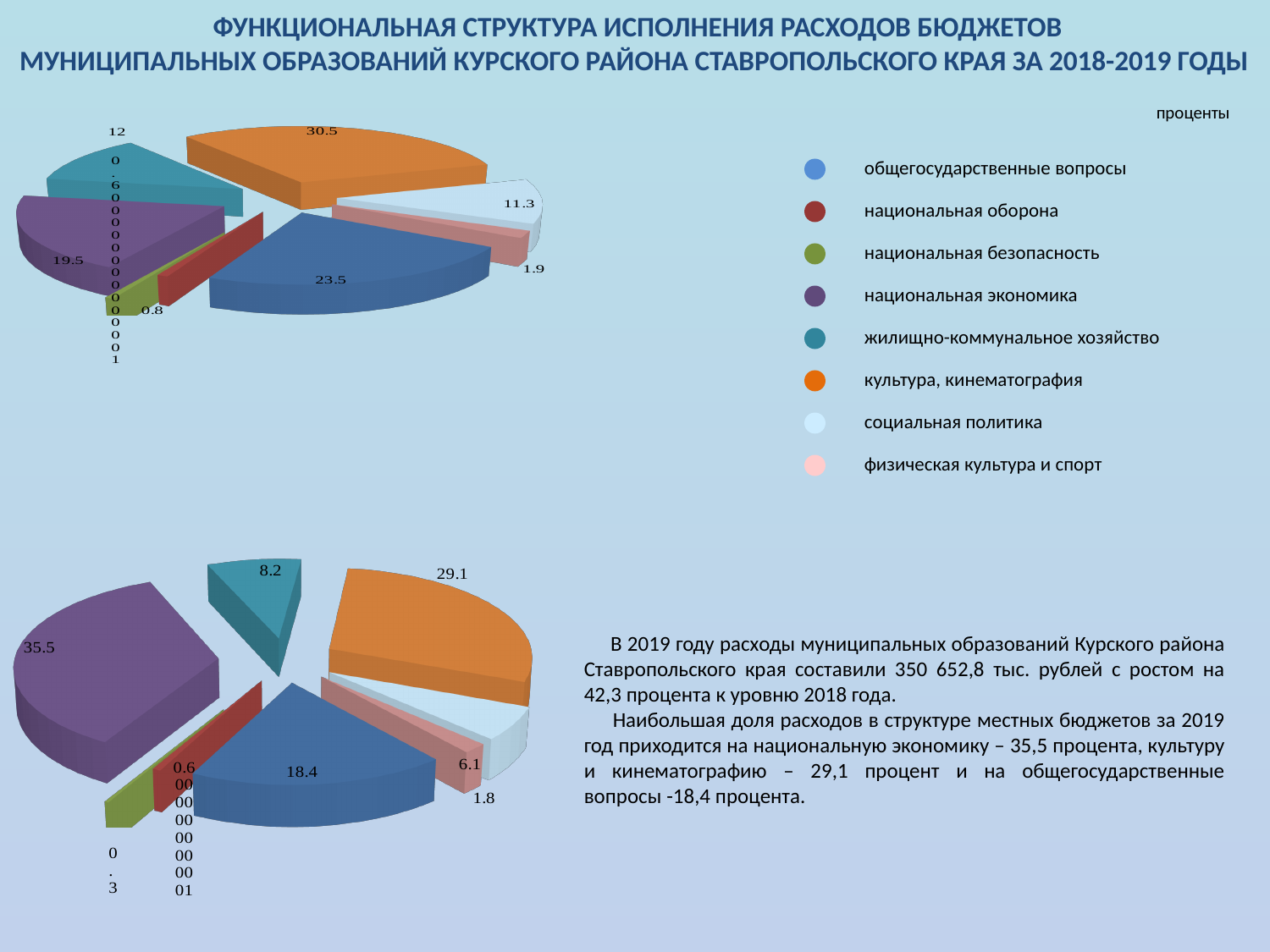
In the top pie chart, what is the value for общегосударственные вопросы? 23.5 In the top pie chart, which category has the largest slice? культура, кинематография How many categories does the legend list? 8 In the bottom pie chart, what is the difference between the values for культура, кинематография and общегосударственные вопросы? 10.7 In the bottom pie chart, which is larger, the value for общегосударственные вопросы or the value for социальная политика? общегосударственные вопросы In the top pie chart, what is the difference between the values for социальная политика and физическая культура и спорт? 9.4 What type of chart is the bottom chart? pie chart In the bottom pie chart, what is the value for жилищно-коммунальное хозяйство? 8.2 In the bottom pie chart, what is the value for национальная экономика? 35.5 In the top pie chart, what is the value for культура, кинематография? 30.5 In the top pie chart, what is the value for национальная экономика? 19.5 In the bottom pie chart, which category has the largest slice? национальная экономика